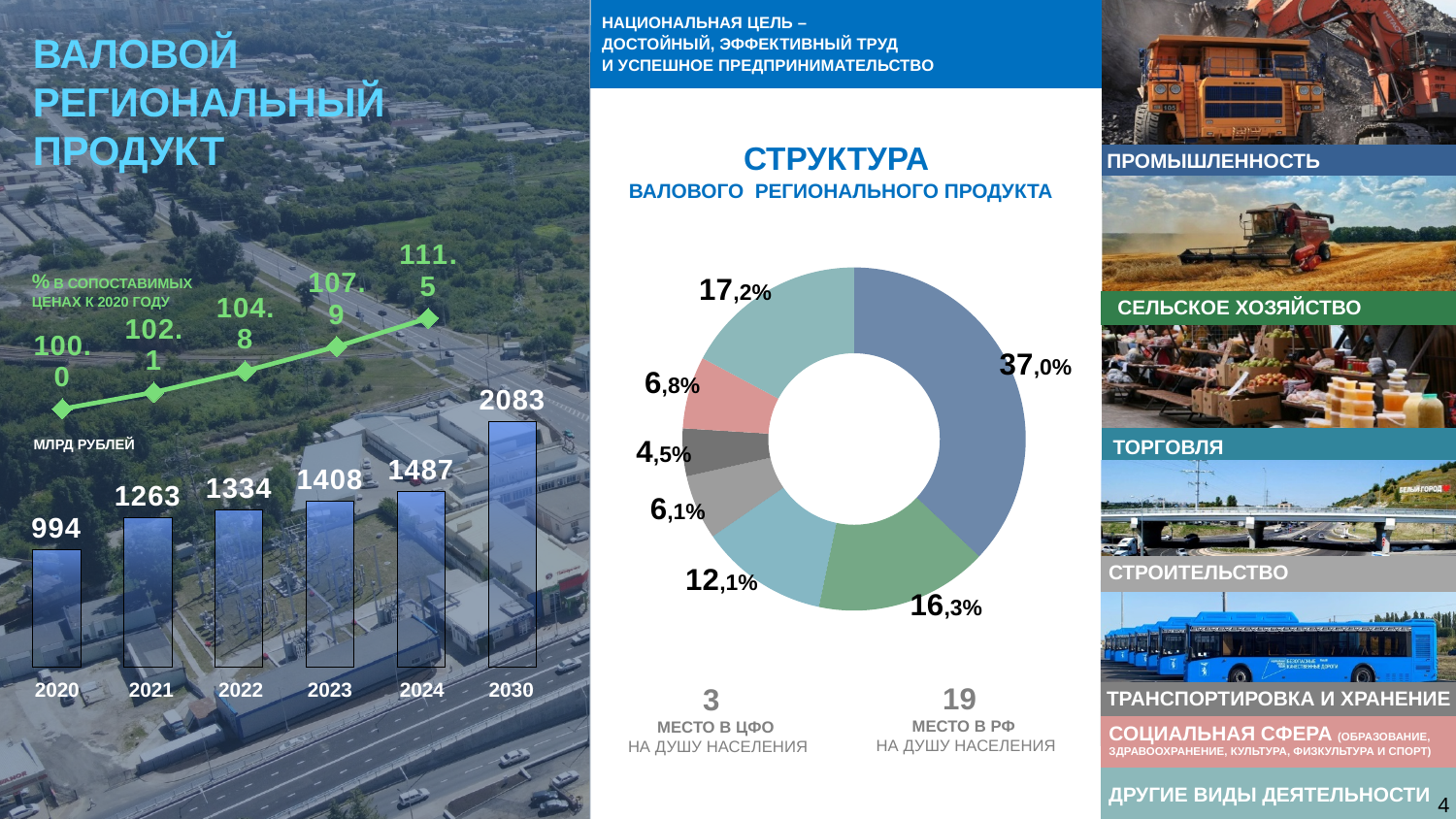
In the left chart, do the bar values rise or fall from 2020 to 2030? rise In the pie chart СТРУКТУРА ВАЛОВОГО РЕГИОНАЛЬНОГО ПРОДУКТА, what is the share of the largest slice? 37,0% In the left chart, what is the value of the line (% в сопоставимых ценах к 2020 году) for 2024? 111.5 In the left chart, what is the difference in млрд рублей between 2024 and 2023? 79 In the left chart, what is the value of the line (% в сопоставимых ценах к 2020 году) for 2022? 104.8 In the left chart, what is the value in млрд рублей for 2030? 2083 In the left chart, which year has the lowest value in млрд рублей? 2020 In the left chart, what is the value in млрд рублей for 2023? 1408 In the left chart, which year has the highest value in млрд рублей? 2030 In the left chart, how many years are shown on the x axis? 6 In the pie chart СТРУКТУРА ВАЛОВОГО РЕГИОНАЛЬНОГО ПРОДУКТА, how many slices are there? 7 In the left chart (ВАЛОВОЙ РЕГИОНАЛЬНЫЙ ПРОДУКТ), what is the value in млрд рублей for 2020? 994